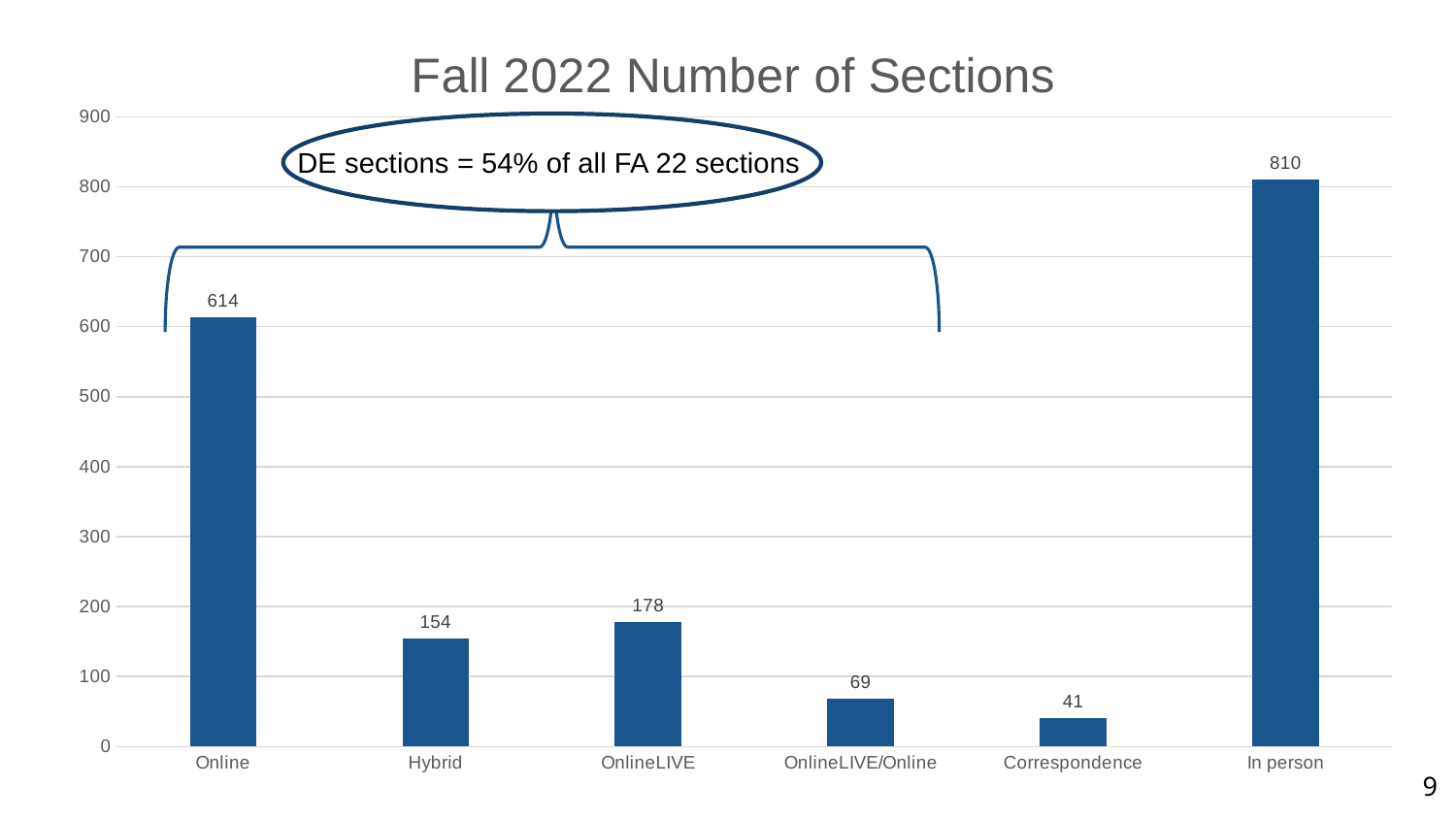
What is the number of sections for Correspondence? 41 What is the difference between the In person and Online section counts? 196 What is the number of sections for Online? 614 Is the value for Hybrid greater or less than 200? less Which has more sections, OnlineLIVE or OnlineLIVE/Online? OnlineLIVE Which category has the lowest number of sections? Correspondence How many categories are shown on the x axis? 6 What is the number of sections for Hybrid? 154 What is the title of the chart? Fall 2022 Number of Sections Which category has the highest number of sections? In person What is the difference between the OnlineLIVE and Hybrid section counts? 24 What kind of chart is shown on the slide? Bar chart